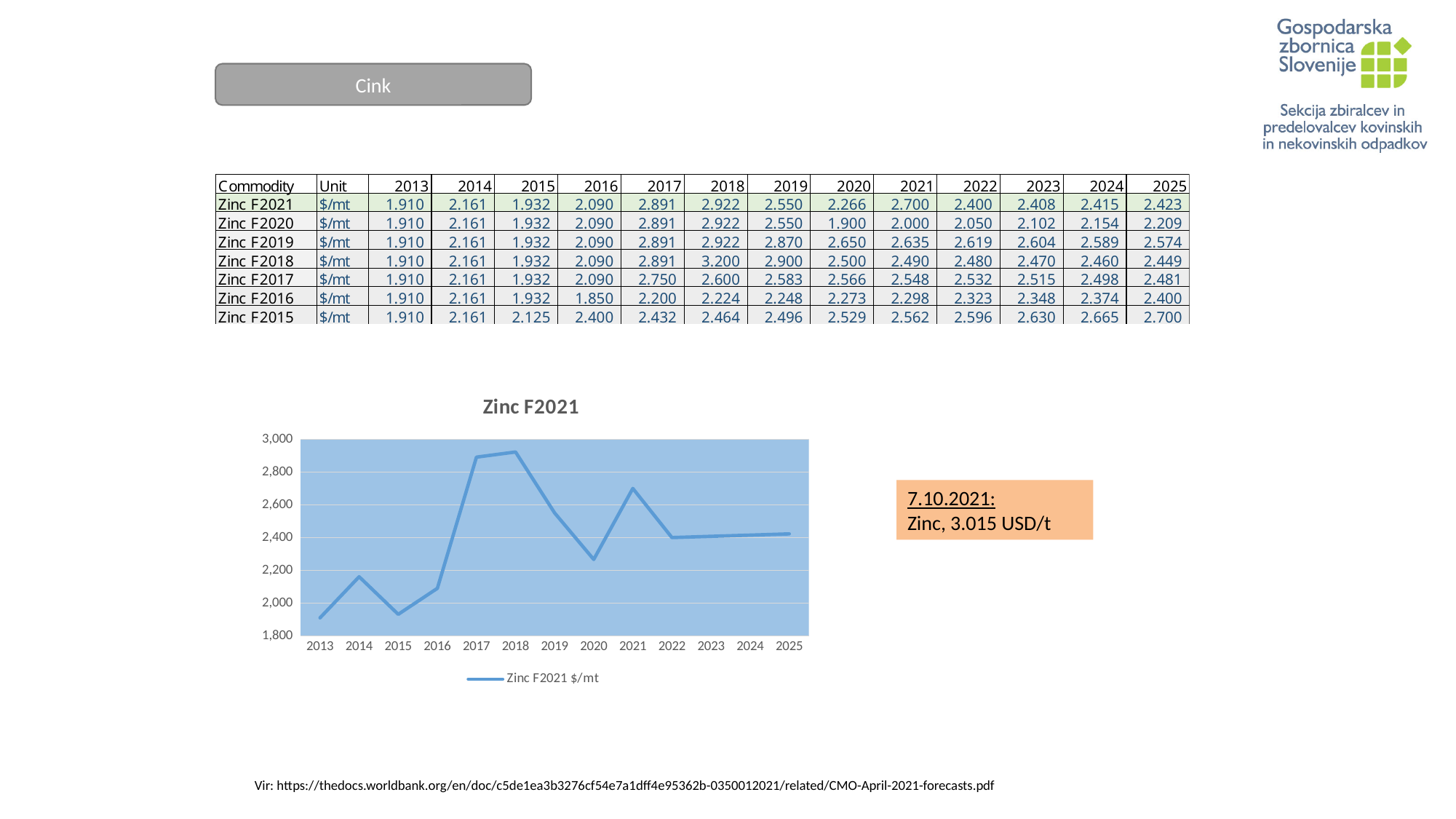
How many years are plotted along the x axis of the Zinc F2021 chart? 13 What is the legend entry shown below the Zinc F2021 chart? Zinc F2021 $/mt In the Zinc F2021 chart, which year has the lowest value? 2013 In the Zinc F2021 chart, is the value for 2021 greater or less than 2,600? greater What kind of chart is the Zinc F2021 chart? line chart According to the table on the slide, what is the Zinc F2021 value for 2025? 2.423 In the Zinc F2021 chart, which year has the highest value? 2018 In the Zinc F2021 chart, is the value for 2020 greater or less than 2,400? less In the Zinc F2021 chart, do the values rise or fall from 2018 to 2020? fall In the Zinc F2021 chart, is the value for 2017 greater or less than 2,800? greater How many series does the legend of the Zinc F2021 chart list? 1 In the Zinc F2021 chart, which year has the larger value, 2021 or 2022? 2021